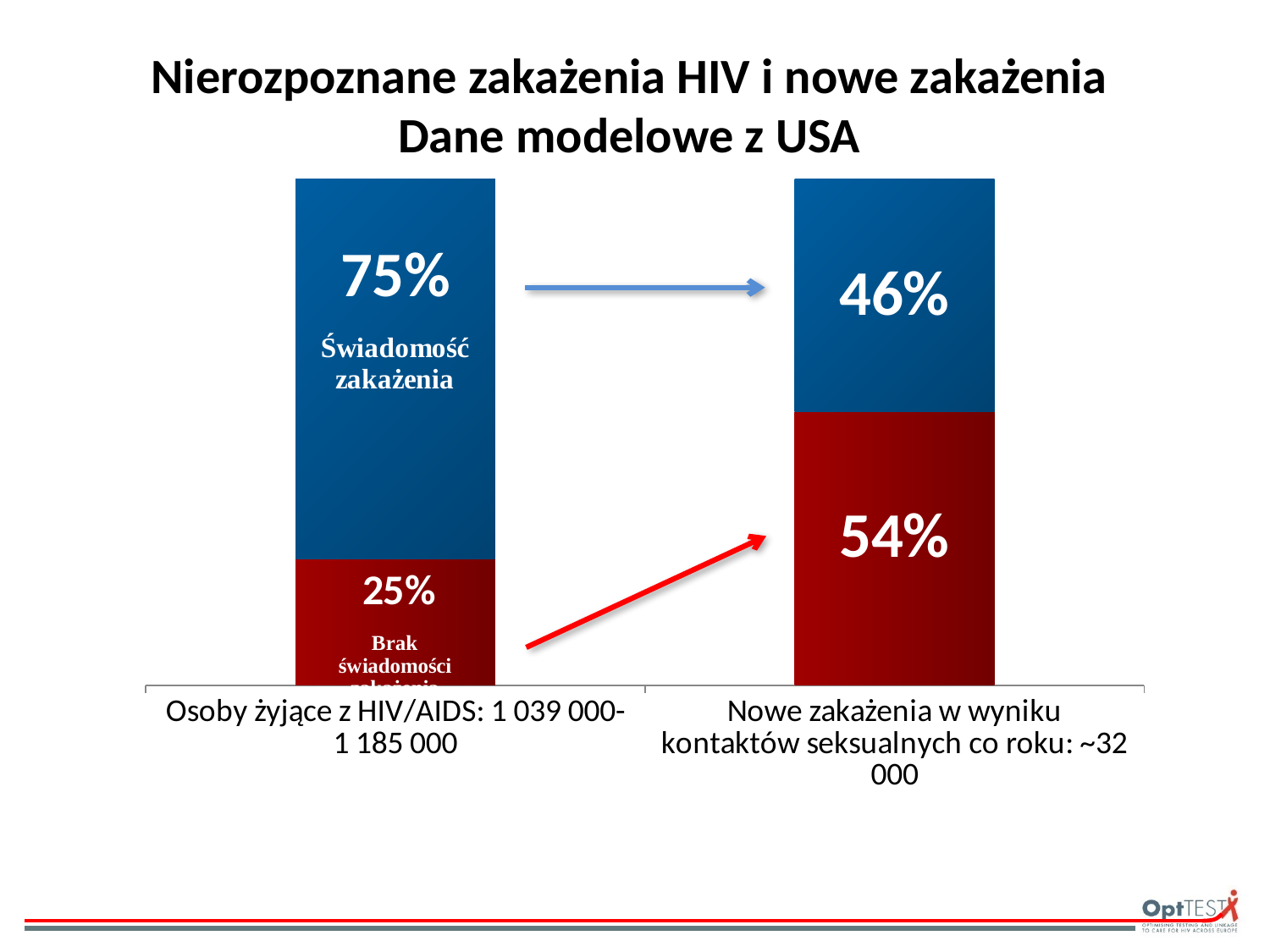
What is the title of the chart on the slide? Nierozpoznane zakażenia HIV i nowe zakażenia Dane modelowe z USA Which bar has the larger red (Brak świadomości zakażenia) segment? Nowe zakażenia w wyniku kontaktów seksualnych co roku How many bars (categories) are shown in the chart? 2 Which bar has the larger blue (Świadomość zakażenia) segment? Osoby żyjące z HIV/AIDS What is the blue (Świadomość zakażenia) value for the bar 'Nowe zakażenia w wyniku kontaktów seksualnych co roku'? 46% What is the difference between the red segment values of the two bars (54% and 25%)? 29% What is the red (Brak świadomości zakażenia) value for the bar 'Nowe zakażenia w wyniku kontaktów seksualnych co roku'? 54% What is the red (Brak świadomości zakażenia) value for the bar 'Osoby żyjące z HIV/AIDS'? 25% What kind of chart is shown on the slide? stacked bar chart What is the difference between the blue segment values of the two bars (75% and 46%)? 29% What is the total of the stacked bar 'Nowe zakażenia w wyniku kontaktów seksualnych co roku'? 100% What is the blue (Świadomość zakażenia) value for the bar 'Osoby żyjące z HIV/AIDS'? 75%